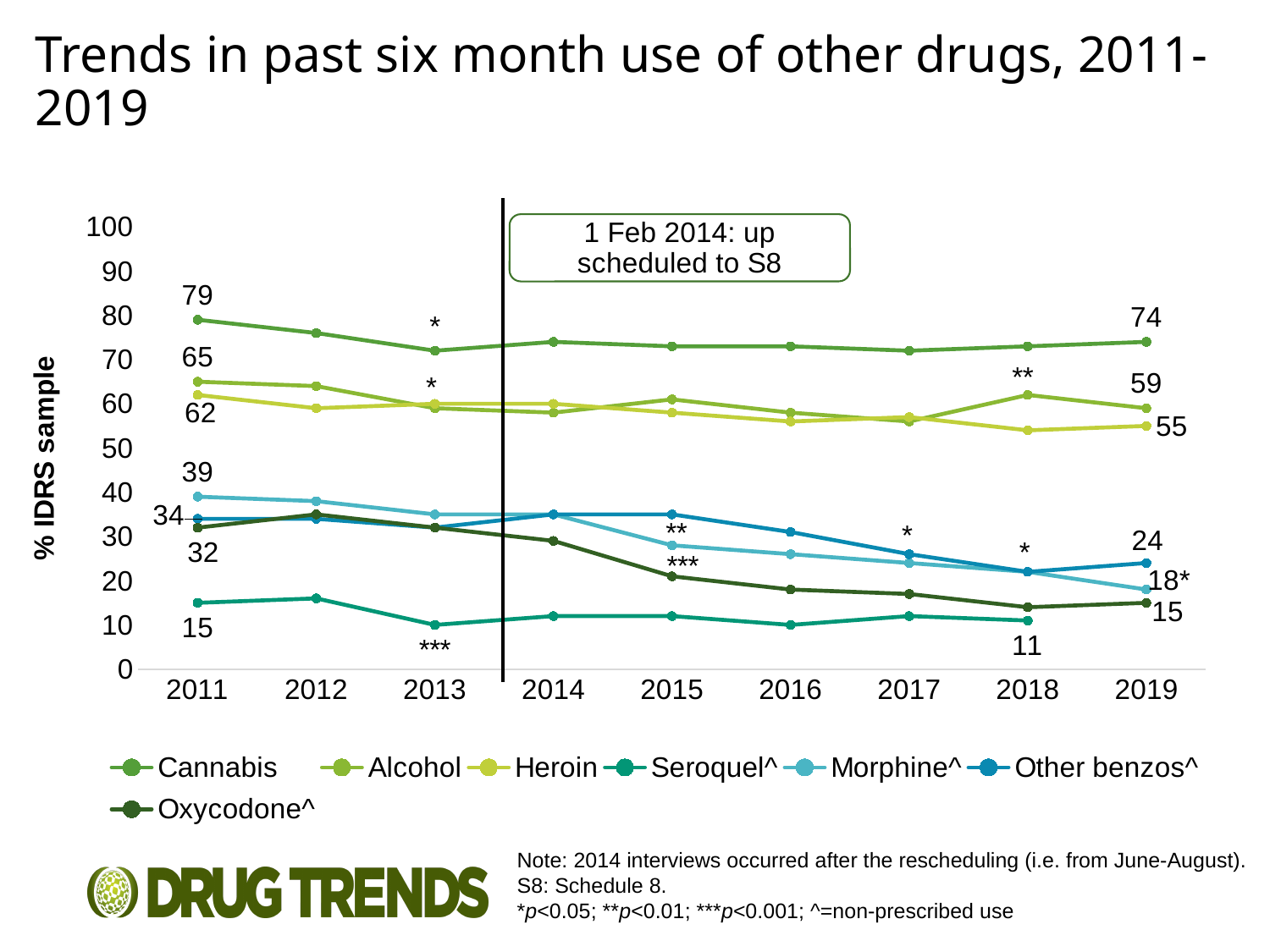
What was the value for Cannabis in 2019? 74 What kind of chart is shown on the slide? line chart By how much did the Cannabis value fall from 2011 to 2019? 5 Which drug had the highest value in 2011? Cannabis Which drug had the lowest value in 2011? Seroquel^ Is the value for Cannabis in 2016 greater or less than 70? greater How many series does the legend list? 7 What was the value for Cannabis in 2011? 79 How many years are plotted along the x axis? 9 What was the value for Seroquel^ in 2018? 11 Did the Morphine^ value rise or fall between 2011 and 2019? fall Which was higher in 2019, Alcohol or Heroin? Alcohol